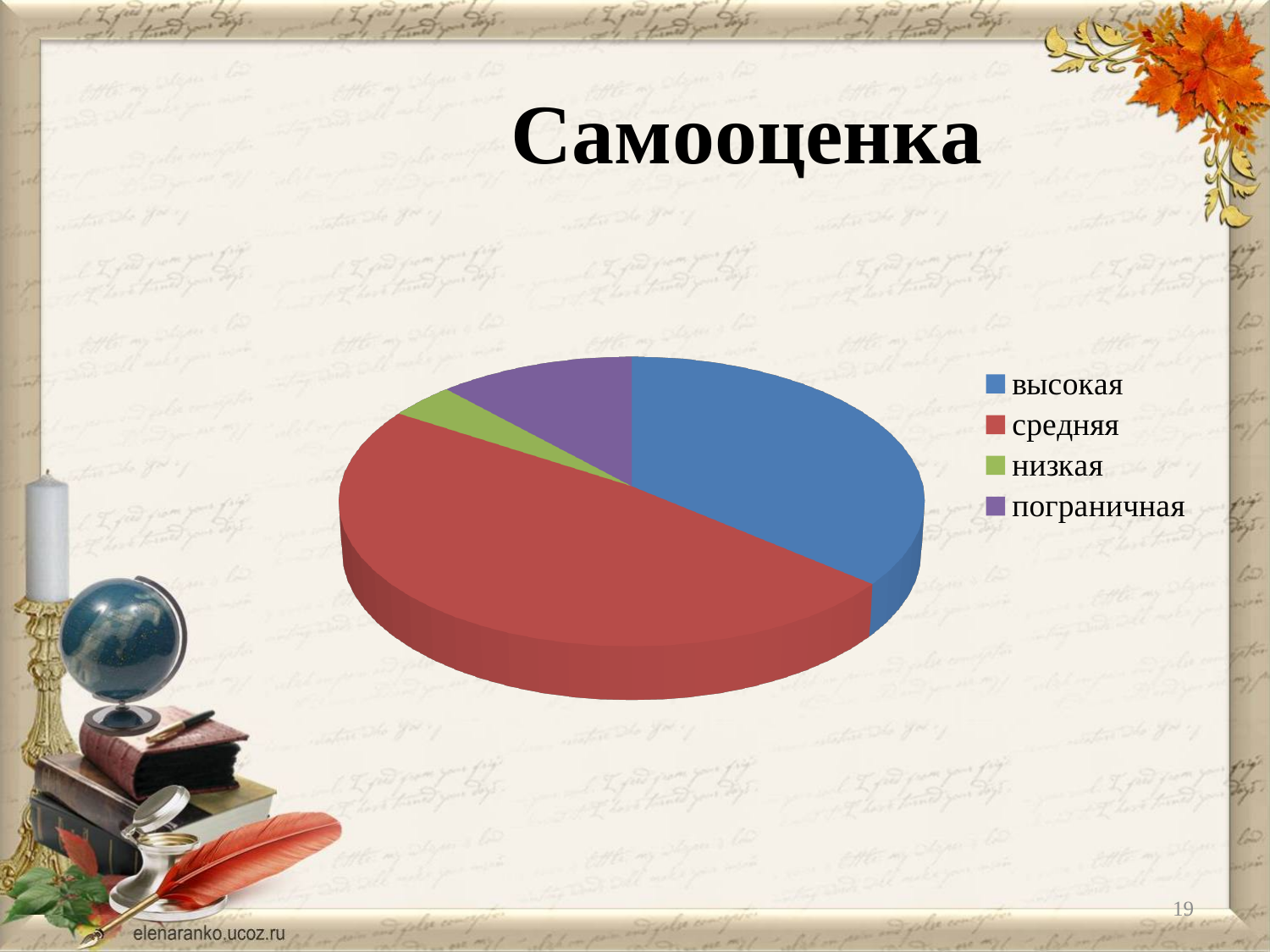
How many entries does the legend list? 4 Which slice is larger, высокая or пограничная? высокая Which category has the smallest slice of the pie? низкая Which category is shown in blue in the legend? высокая Which slice is larger, средняя or высокая? средняя What is the title of the chart? Самооценка Which category has the largest slice of the pie? средняя How many categories does the pie chart have? 4 What kind of chart is shown on the slide? pie chart Which slice is larger, пограничная or низкая? пограничная